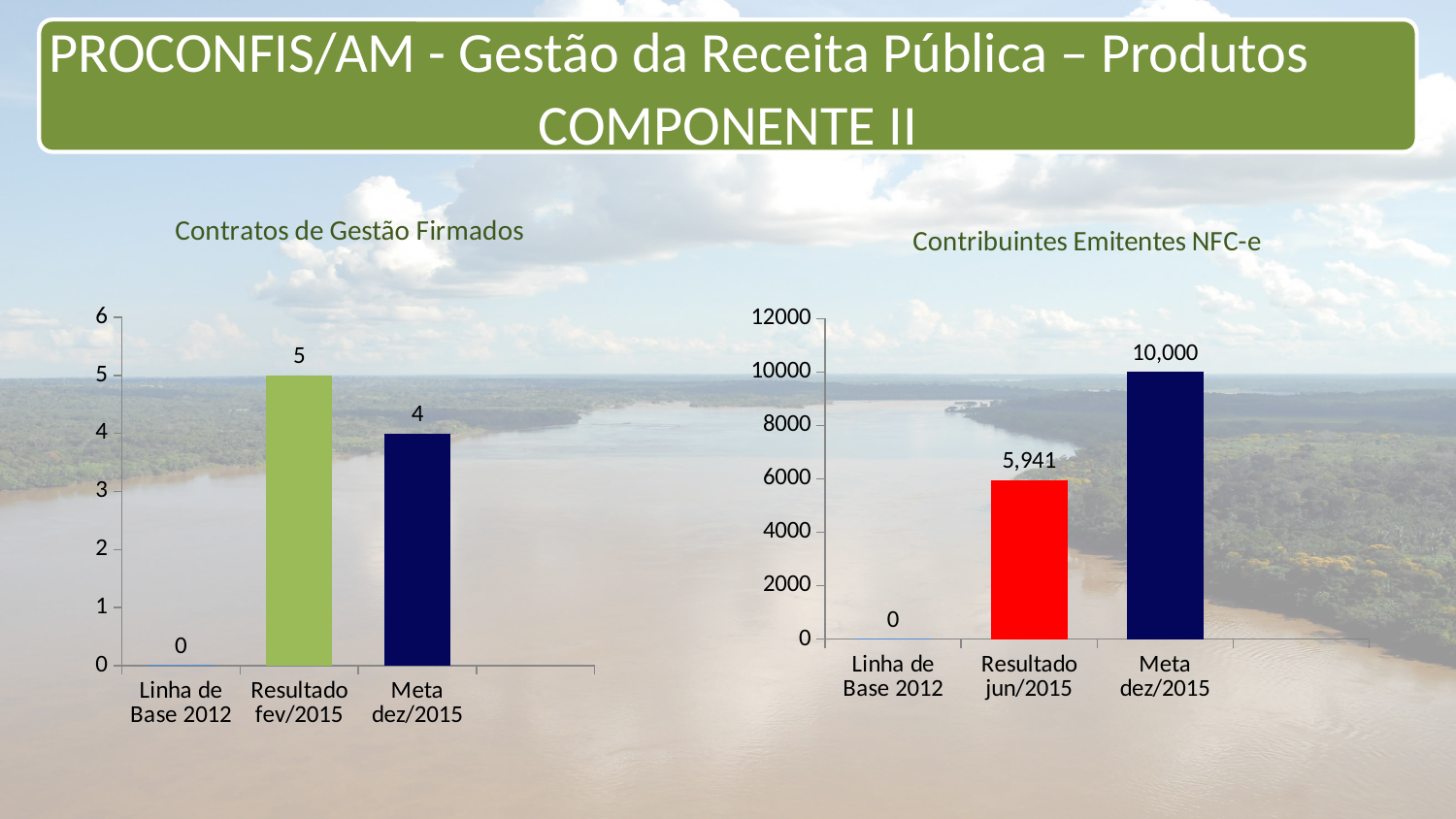
In the 'Contratos de Gestão Firmados' chart, how many categories are shown on the x axis? 3 In the 'Contratos de Gestão Firmados' chart, what is the value for Resultado fev/2015? 5 In the 'Contribuintes Emitentes NFC-e' chart, what is the difference between Meta dez/2015 and Resultado jun/2015? 4,059 In the 'Contratos de Gestão Firmados' chart, what is the difference between Resultado fev/2015 and Meta dez/2015? 1 In the 'Contribuintes Emitentes NFC-e' chart, which category has the lowest value? Linha de Base 2012 In the 'Contribuintes Emitentes NFC-e' chart, is the value for Resultado jun/2015 greater or less than 4000? greater In the 'Contribuintes Emitentes NFC-e' chart, what is the value for Meta dez/2015? 10,000 What kind of chart is the 'Contribuintes Emitentes NFC-e' chart? bar chart In the 'Contratos de Gestão Firmados' chart, which category has the highest value? Resultado fev/2015 In the 'Contribuintes Emitentes NFC-e' chart, what colour is the bar for Resultado jun/2015? red In the 'Contribuintes Emitentes NFC-e' chart, what is the value for Resultado jun/2015? 5,941 In the 'Contratos de Gestão Firmados' chart, what is the value for Meta dez/2015? 4